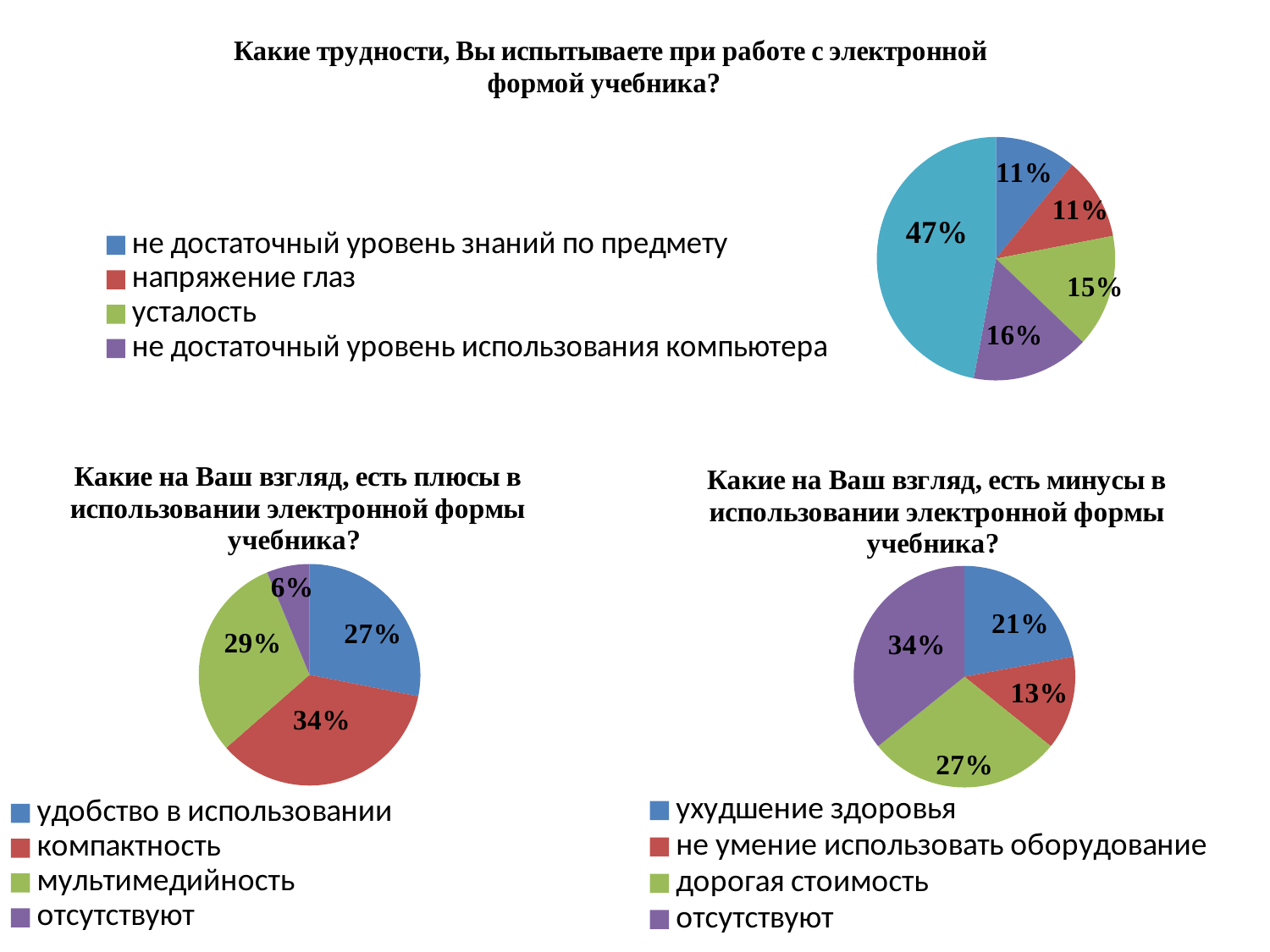
In the top chart 'Какие трудности, Вы испытываете при работе с электронной формой учебника?', what is the largest percentage label shown on the pie? 47% In the bottom-left chart 'Какие на Ваш взгляд, есть плюсы в использовании электронной формы учебника?', what share is shown for 'компактность'? 34% How many entries does the legend of the top chart 'Какие трудности, Вы испытываете при работе с электронной формой учебника?' list? 4 In the bottom-right chart 'Какие на Ваш взгляд, есть минусы в использовании электронной формы учебника?', which is larger: 'ухудшение здоровья' or 'не умение использовать оборудование'? ухудшение здоровья How many slices does the bottom-right chart 'Какие на Ваш взгляд, есть минусы в использовании электронной формы учебника?' have? 4 In the bottom-right chart 'Какие на Ваш взгляд, есть минусы в использовании электронной формы учебника?', which category has the largest share? отсутствуют In the bottom-right chart 'Какие на Ваш взгляд, есть минусы в использовании электронной формы учебника?', what share is shown for 'дорогая стоимость'? 27% What kind of chart is the bottom-left chart 'Какие на Ваш взгляд, есть плюсы в использовании электронной формы учебника?'? Pie chart In the bottom-left chart 'Какие на Ваш взгляд, есть плюсы в использовании электронной формы учебника?', what is the difference between the shares for 'мультимедийность' and 'удобство в использовании'? 2% In the top chart 'Какие трудности, Вы испытываете при работе с электронной формой учебника?', what share is shown for 'усталость'? 15% In the top chart 'Какие трудности, Вы испытываете при работе с электронной формой учебника?', what share is shown for 'не достаточный уровень использования компьютера'? 16% In the bottom-left chart 'Какие на Ваш взгляд, есть плюсы в использовании электронной формы учебника?', which category has the smallest share? отсутствуют